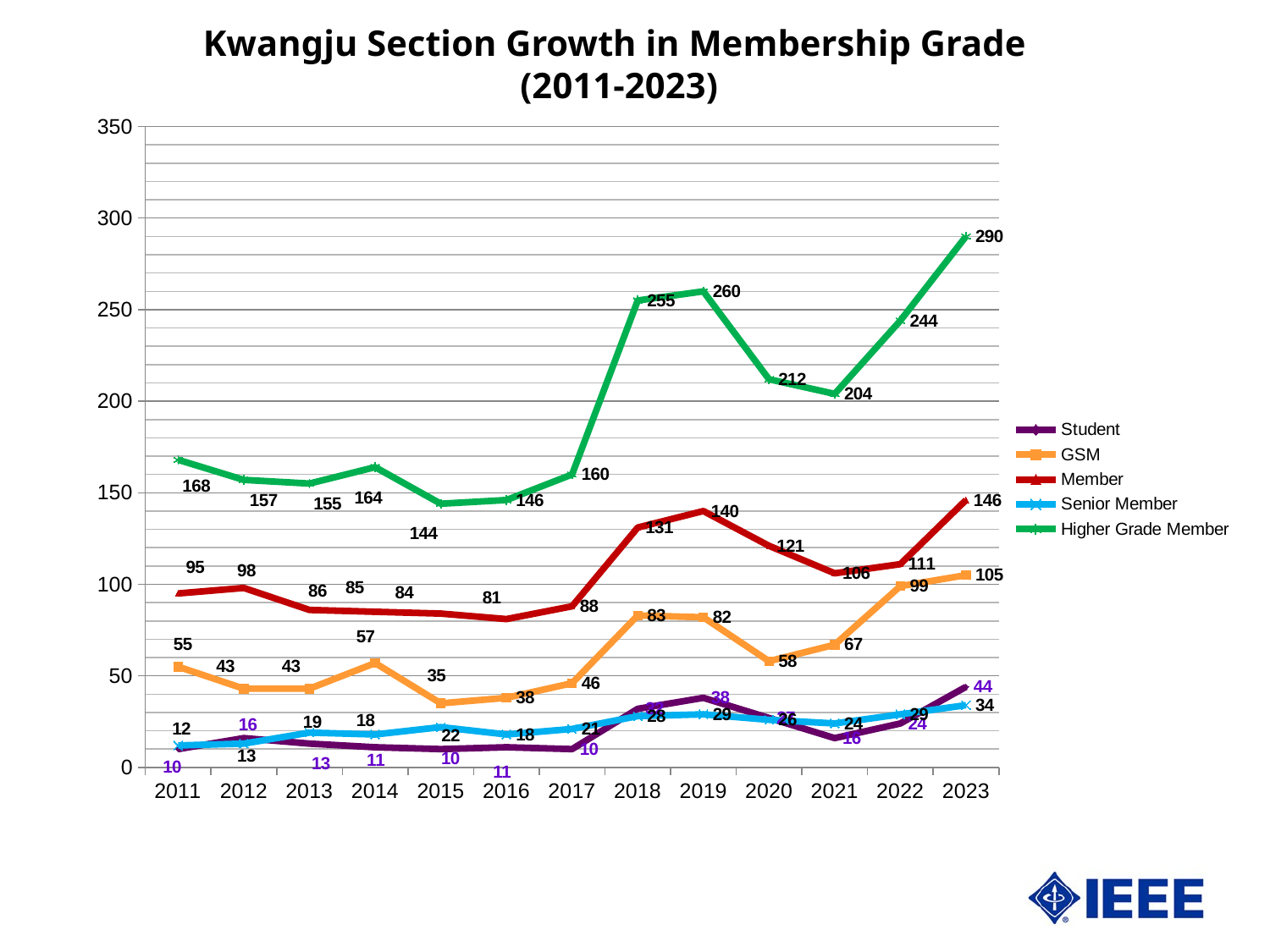
In 2022, which is larger: the GSM value or the Member value? Member How many series does the legend list? 5 In which year is the Higher Grade Member value highest? 2023 In which year is the Higher Grade Member value lowest? 2015 Does the Higher Grade Member value rise or fall from 2021 to 2023? rise What is the Higher Grade Member value for 2023? 290 What colour is the Higher Grade Member line? green What is the difference between the Member value in 2023 and in 2022? 35 What is the Senior Member value for 2023? 34 What kind of chart is shown on the slide? line chart What is the GSM value for 2014? 57 How many years are plotted along the x axis? 13